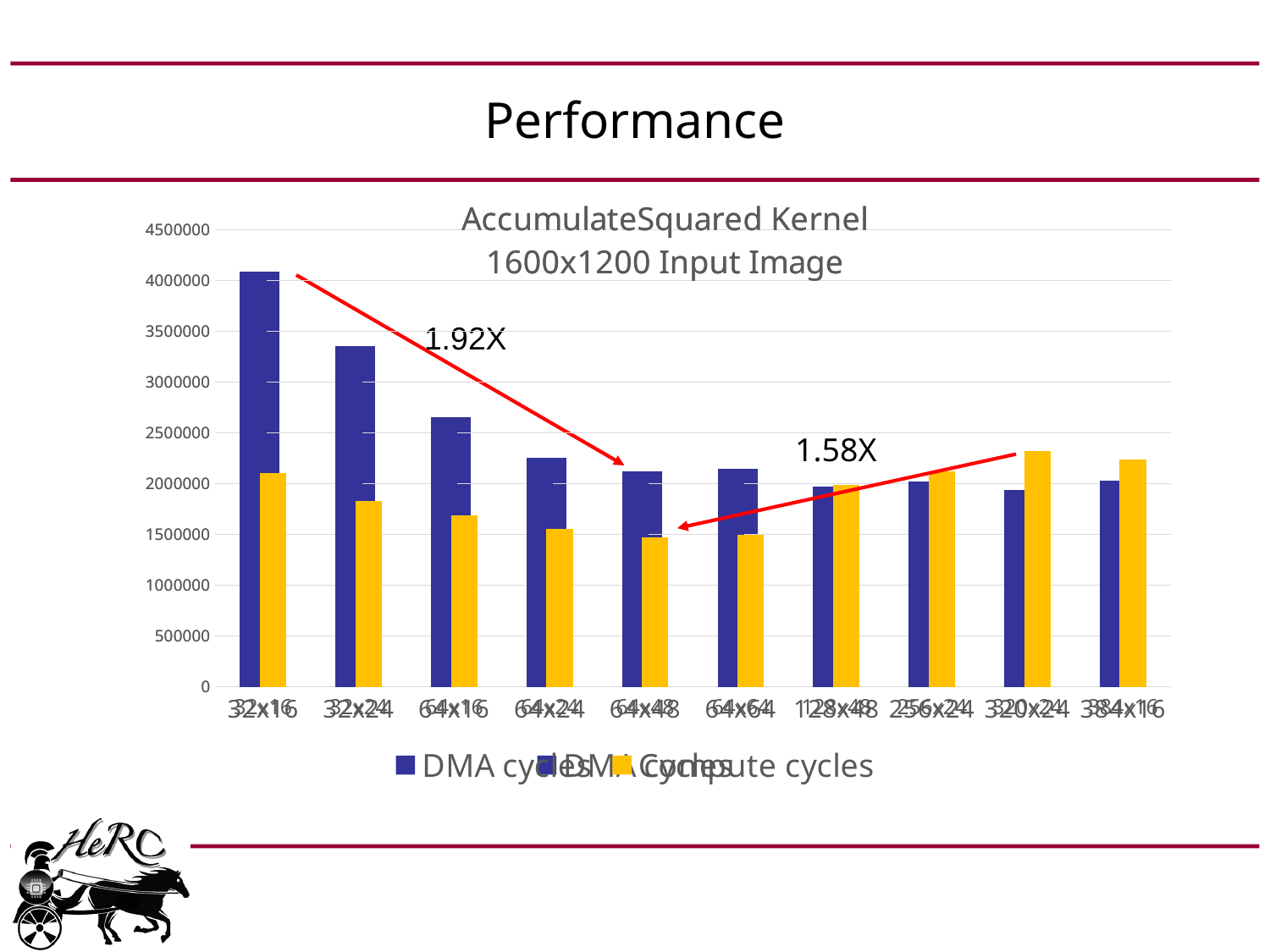
What kind of chart is shown on the slide? bar chart Is the Compute cycles value for 64x24 greater or less than 2000000? less How many categories are shown on the x axis of the chart? 10 Do the DMA cycles values rise or fall from 32x16 to 64x48? fall Is the DMA cycles value for 32x24 greater or less than 3000000? greater Is the DMA cycles value for 32x16 greater or less than 4000000? greater Which category has the highest DMA cycles value? 32x16 At 32x16, which is larger: DMA cycles or Compute cycles? DMA cycles How many series does the chart's legend list? 2 What is the title of the chart? AccumulateSquared Kernel 1600x1200 Input Image At 320x24, which is larger: DMA cycles or Compute cycles? Compute cycles